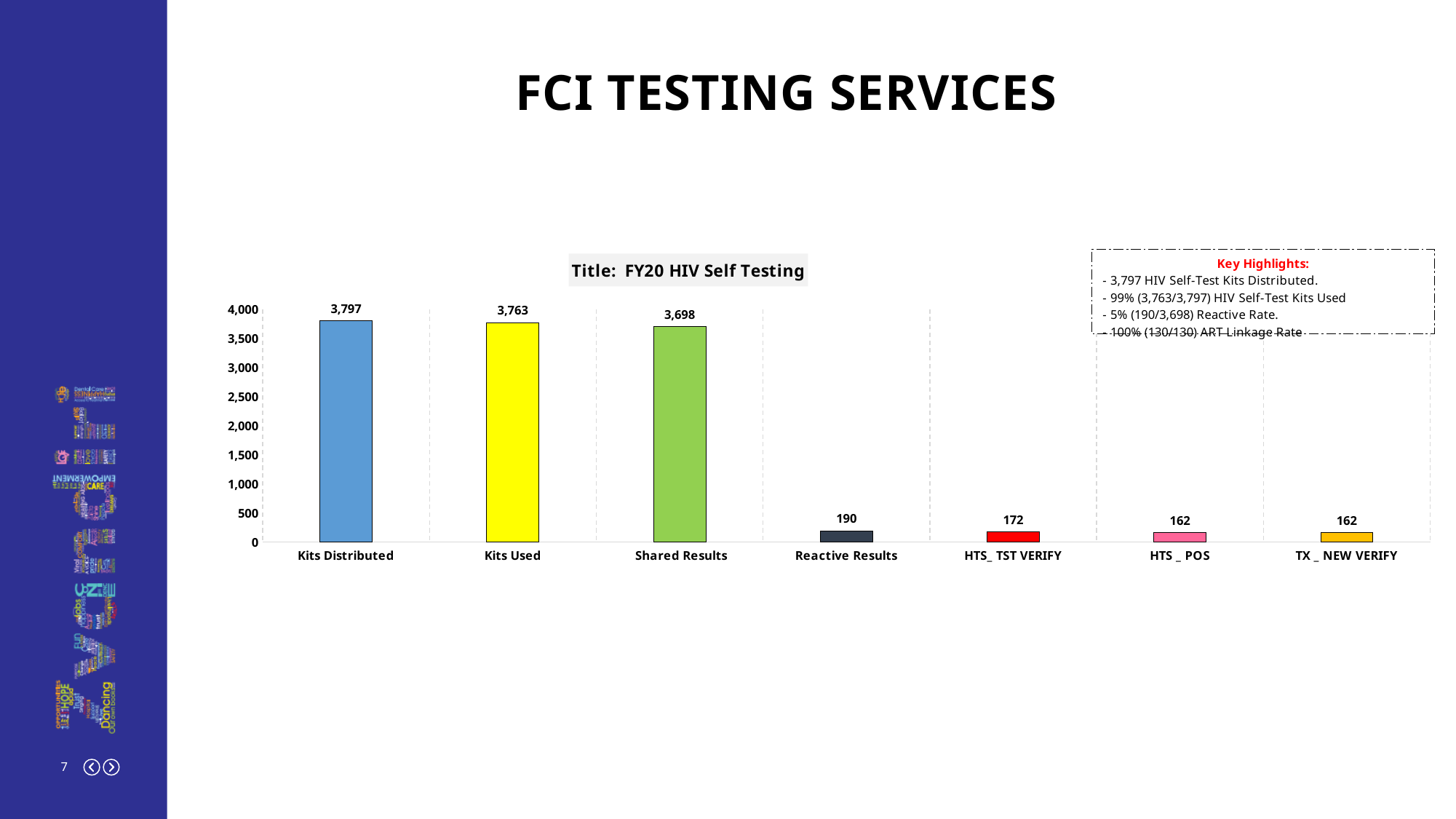
What is the value for Shared Results? 3,698 What is the value for HTS_ TST VERIFY? 172 What is the title of the chart? Title: FY20 HIV Self Testing What is the value for Kits Distributed? 3,797 What is the difference between Kits Distributed and Kits Used? 34 What kind of chart is shown? Bar chart How many categories are shown on the x axis? 7 What is the difference between Reactive Results and HTS_ TST VERIFY? 18 Which is larger, Kits Used or Shared Results? Kits Used Which category has the highest value? Kits Distributed What is the value for Reactive Results? 190 Is the value for Shared Results greater or less than 3,500? greater